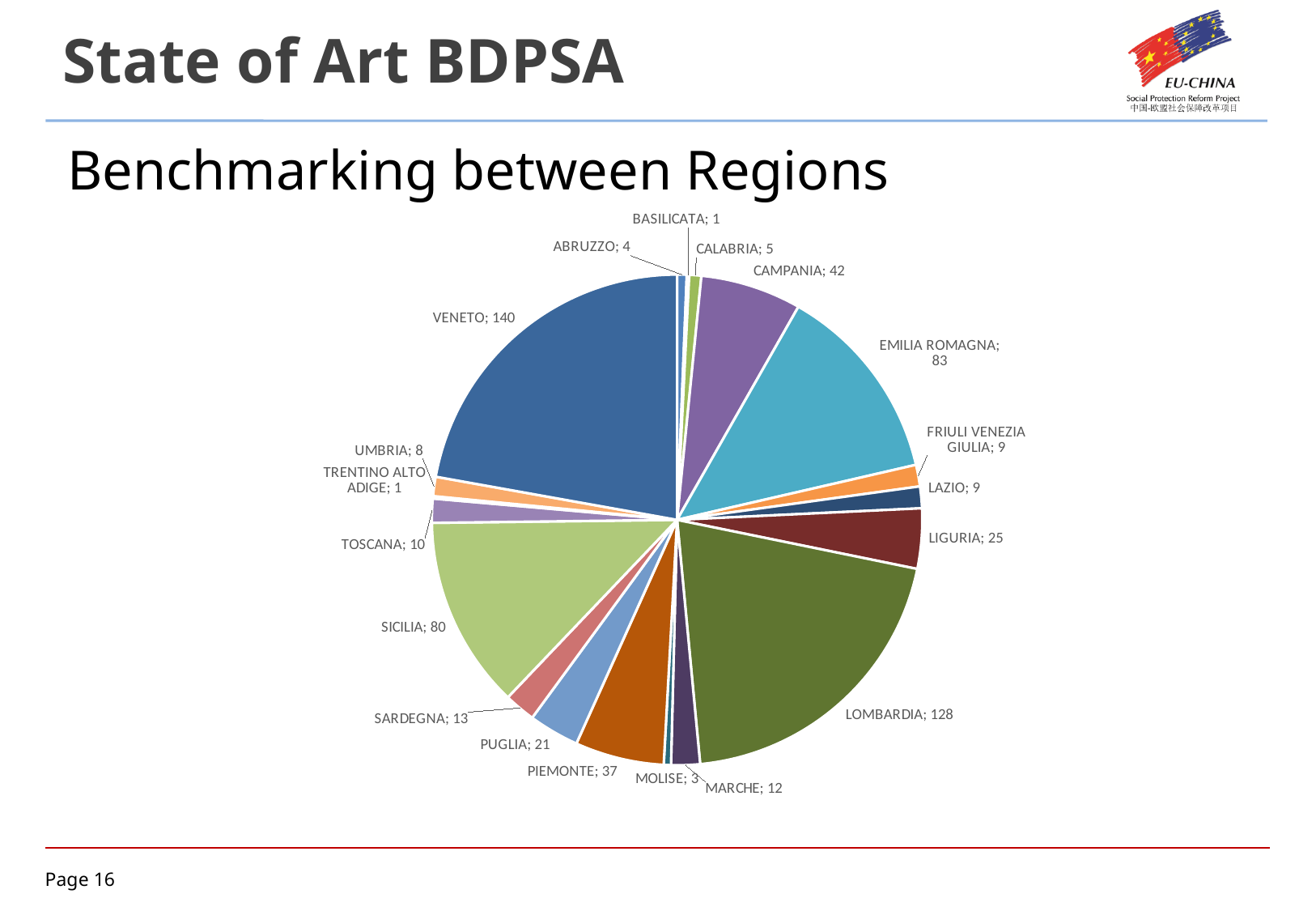
What is the difference between the values for VENETO and LOMBARDIA? 12 Which has a larger value, CAMPANIA or LIGURIA? CAMPANIA Which region has the largest slice of the pie chart? VENETO What kind of chart is shown on the slide? Pie chart Which has a larger value, PUGLIA or MARCHE? PUGLIA What value is shown for PIEMONTE? 37 How many regions are shown in the pie chart? 19 What is the difference between the values for EMILIA ROMAGNA and SICILIA? 3 What value is shown for SARDEGNA? 13 What value is shown for EMILIA ROMAGNA? 83 What value is shown for VENETO in the pie chart? 140 What is the subtitle above the chart? Benchmarking between Regions